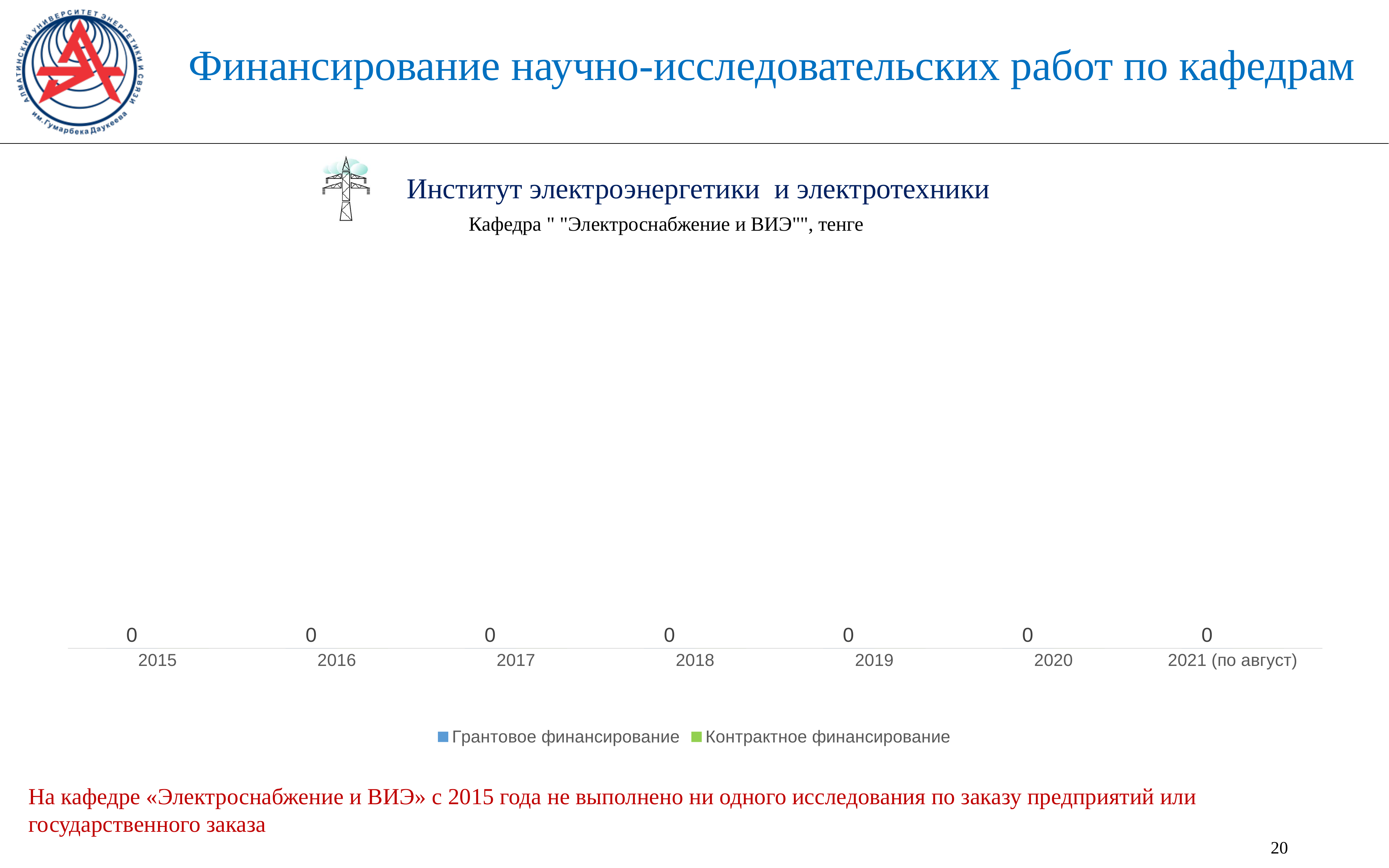
What is the value shown for 2021 (по август)? 0 What value is shown for 2020? 0 How many series does the legend list? 2 How many year categories are shown on the x axis? 7 What is the label of the last category on the x axis? 2021 (по август) What is the title of the chart? Кафедра " "Электроснабжение и ВИЭ"", тенге What is the difference between the values shown for 2016 and 2019? 0 What value is printed above the 2018 category? 0 Do the values rise, fall, or stay the same from 2015 to 2021 (по август)? stay the same What is the data label shown for 2015 on the chart? 0